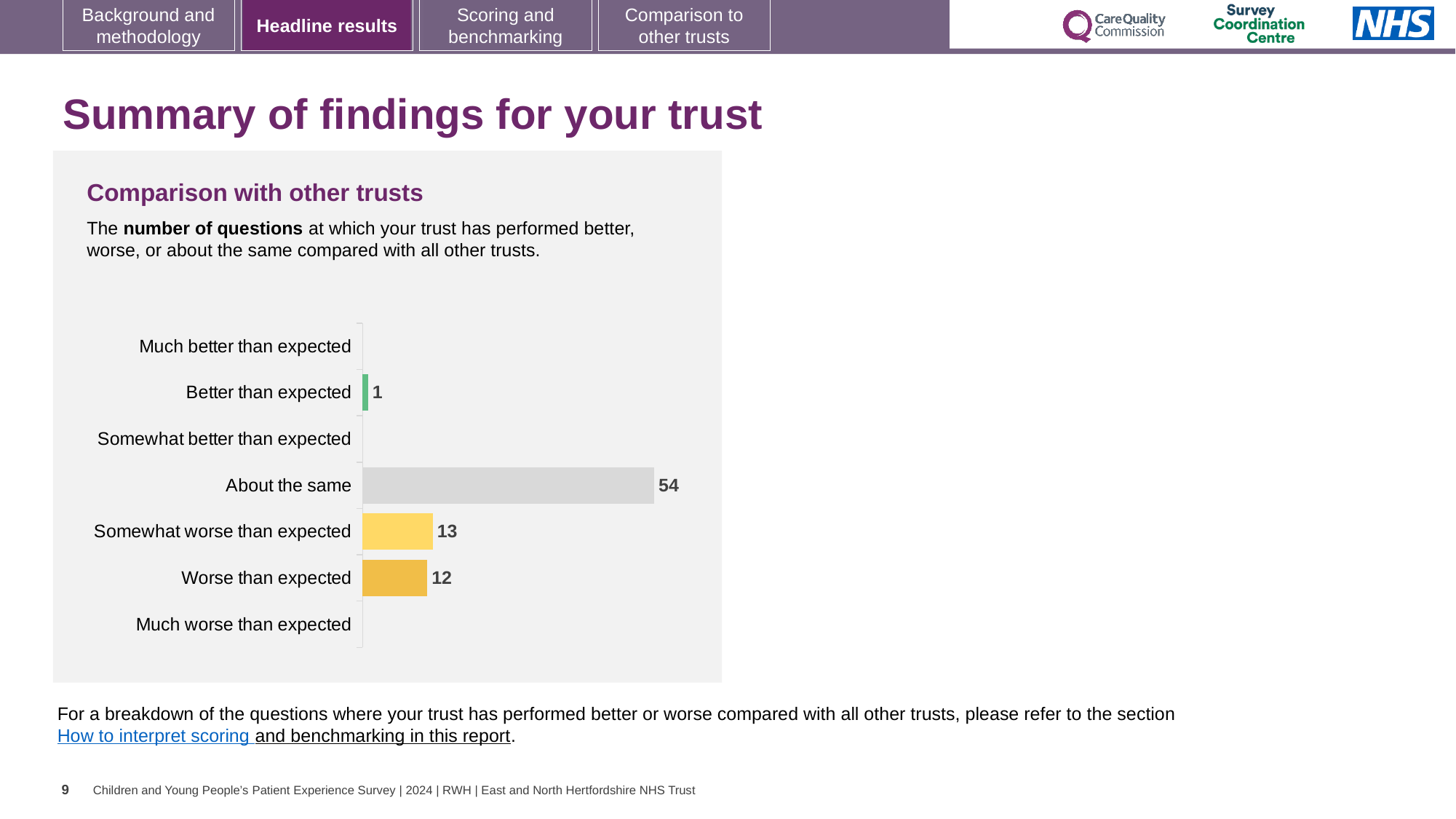
What is the total of the 'Somewhat worse than expected' and 'Worse than expected' values? 25 Which is larger, 'Somewhat worse than expected' or 'Better than expected'? Somewhat worse than expected How many questions were rated 'About the same'? 54 What is the value for 'Better than expected'? 1 What kind of chart is shown on the slide? Bar chart What is the value for 'Somewhat worse than expected'? 13 What is the value for 'Worse than expected'? 12 What is the title of the chart? Comparison with other trusts Which category has the highest number of questions? About the same How many categories are listed on the chart's axis? 7 What is the difference between 'About the same' and 'Somewhat worse than expected'? 41 What is the difference between 'Somewhat worse than expected' and 'Worse than expected'? 1